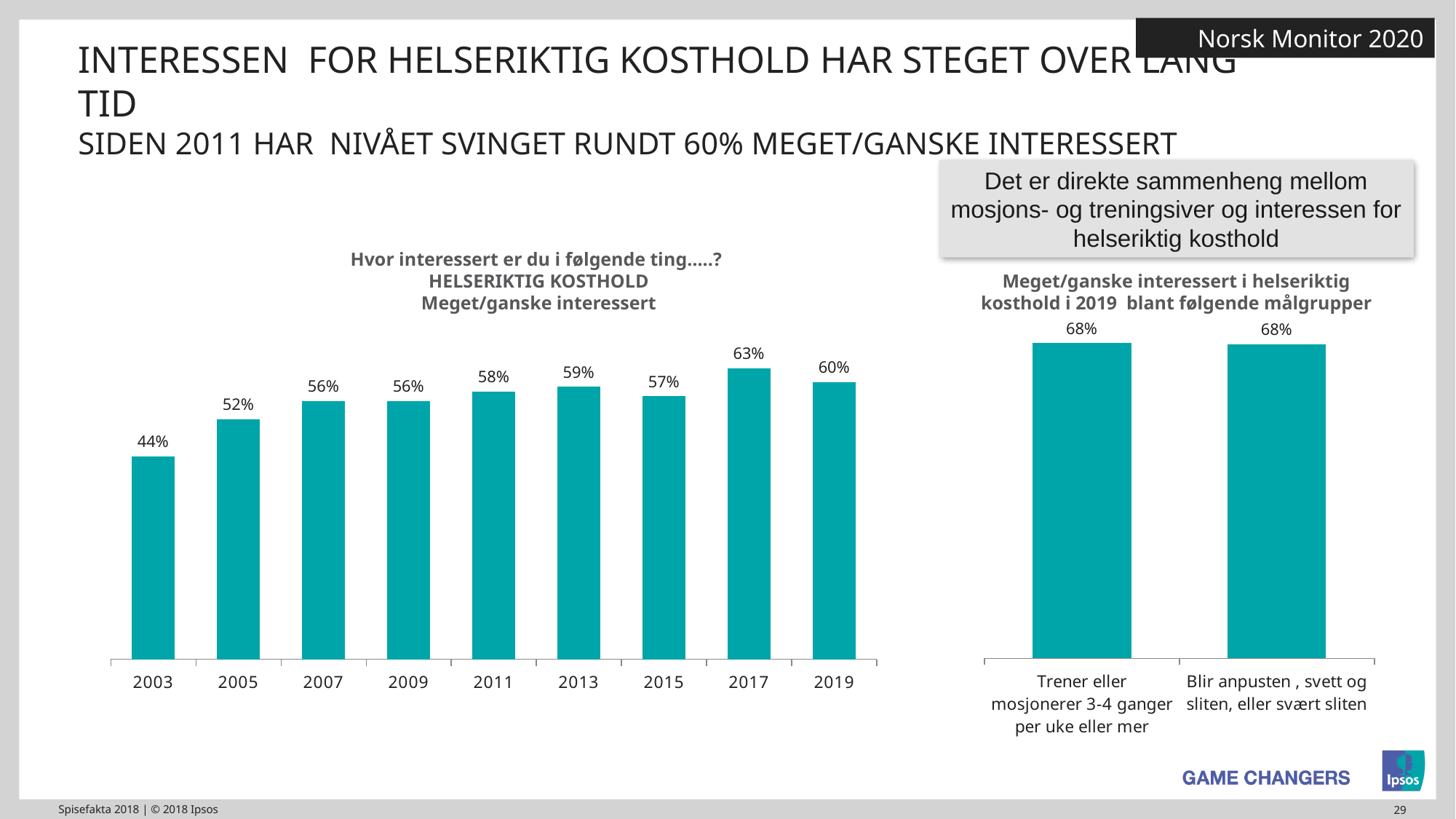
In the left chart (HELSERIKTIG KOSTHOLD, Meget/ganske interessert), what is the value for 2003? 44% In the left chart (HELSERIKTIG KOSTHOLD, Meget/ganske interessert), which is larger, the value for 2013 or the value for 2015? 2013 In the right chart (Meget/ganske interessert i helseriktig kosthold i 2019 blant følgende målgrupper), how many categories are shown? 2 In the left chart (HELSERIKTIG KOSTHOLD, Meget/ganske interessert), which year has the highest value? 2017 In the left chart (HELSERIKTIG KOSTHOLD, Meget/ganske interessert), how many years are shown on the x axis? 9 In the left chart (HELSERIKTIG KOSTHOLD, Meget/ganske interessert), what is the value for 2011? 58% In the left chart (HELSERIKTIG KOSTHOLD, Meget/ganske interessert), do the values generally rise or fall from 2003 to 2019? Rise In the left chart (HELSERIKTIG KOSTHOLD, Meget/ganske interessert), which year has the lowest value? 2003 In the right chart (Meget/ganske interessert i helseriktig kosthold i 2019 blant følgende målgrupper), what is the value for 'Trener eller mosjonerer 3-4 ganger per uke eller mer'? 68% In the left chart (HELSERIKTIG KOSTHOLD, Meget/ganske interessert), what is the difference between the values for 2019 and 2003? 16 percentage points What kind of chart is the left chart (HELSERIKTIG KOSTHOLD, Meget/ganske interessert)? Bar chart In the left chart (HELSERIKTIG KOSTHOLD, Meget/ganske interessert), what is the value for 2019? 60%